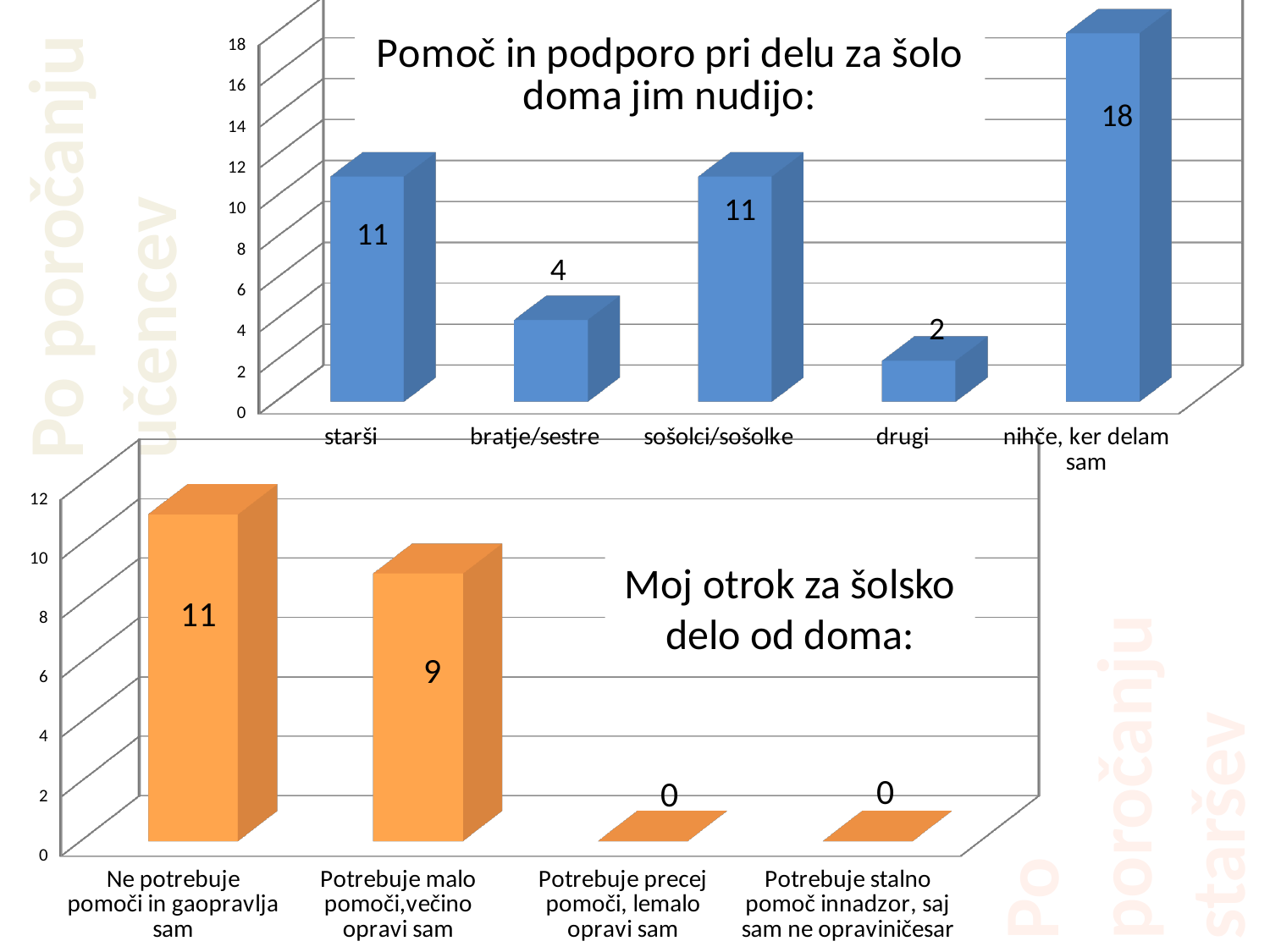
In the top chart 'Pomoč in podporo pri delu za šolo doma jim nudijo:', which is larger, 'bratje/sestre' or 'drugi'? bratje/sestre In the bottom chart 'Moj otrok za šolsko delo od doma:', which category has the highest value? Ne potrebuje pomoči in ga opravlja sam In the top chart 'Pomoč in podporo pri delu za šolo doma jim nudijo:', which category has the lowest value? drugi In the top chart 'Pomoč in podporo pri delu za šolo doma jim nudijo:', how many categories are shown? 5 In the top chart 'Pomoč in podporo pri delu za šolo doma jim nudijo:', what is the value for 'bratje/sestre'? 4 In the top chart 'Pomoč in podporo pri delu za šolo doma jim nudijo:', what is the difference between 'nihče, ker delam sam' and 'starši'? 7 In the bottom chart 'Moj otrok za šolsko delo od doma:', what is the value for 'Potrebuje malo pomoči, večino opravi sam'? 9 In the top chart 'Pomoč in podporo pri delu za šolo doma jim nudijo:', which category has the highest value? nihče, ker delam sam What type of chart is the bottom chart 'Moj otrok za šolsko delo od doma:'? bar chart In the bottom chart 'Moj otrok za šolsko delo od doma:', what is the difference between 'Ne potrebuje pomoči in ga opravlja sam' and 'Potrebuje malo pomoči, večino opravi sam'? 2 In the bottom chart 'Moj otrok za šolsko delo od doma:', how many categories have a value of 0? 2 In the top chart 'Pomoč in podporo pri delu za šolo doma jim nudijo:', what is the value for 'nihče, ker delam sam'? 18